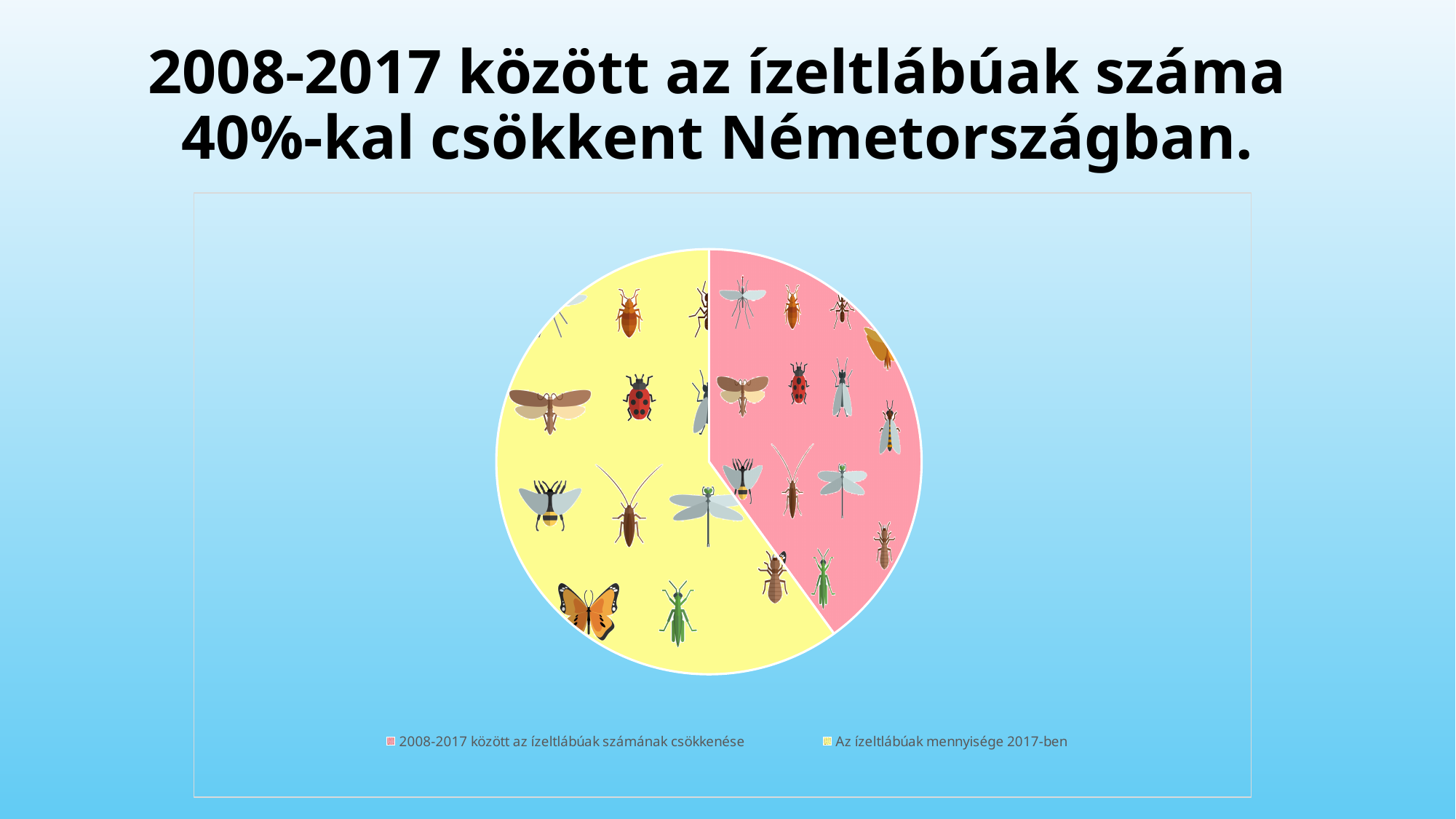
How many slices does the pie chart have? 2 Which category has the smallest slice in the pie chart? 2008-2017 között az ízeltlábúak számának csökkenése Is the yellow slice of the pie chart greater or less than half of the pie? greater What colour is the slice for "Az ízeltlábúak mennyisége 2017-ben" in the pie chart? yellow What colour is the slice for "2008-2017 között az ízeltlábúak számának csökkenése" in the pie chart? pink Which slice of the pie chart is larger: "2008-2017 között az ízeltlábúak számának csökkenése" or "Az ízeltlábúak mennyisége 2017-ben"? Az ízeltlábúak mennyisége 2017-ben Which category has the largest slice in the pie chart? Az ízeltlábúak mennyisége 2017-ben Is the pink slice of the pie chart greater or less than half of the pie? less What kind of chart is shown on the slide? pie chart How many entries does the legend of the pie chart list? 2